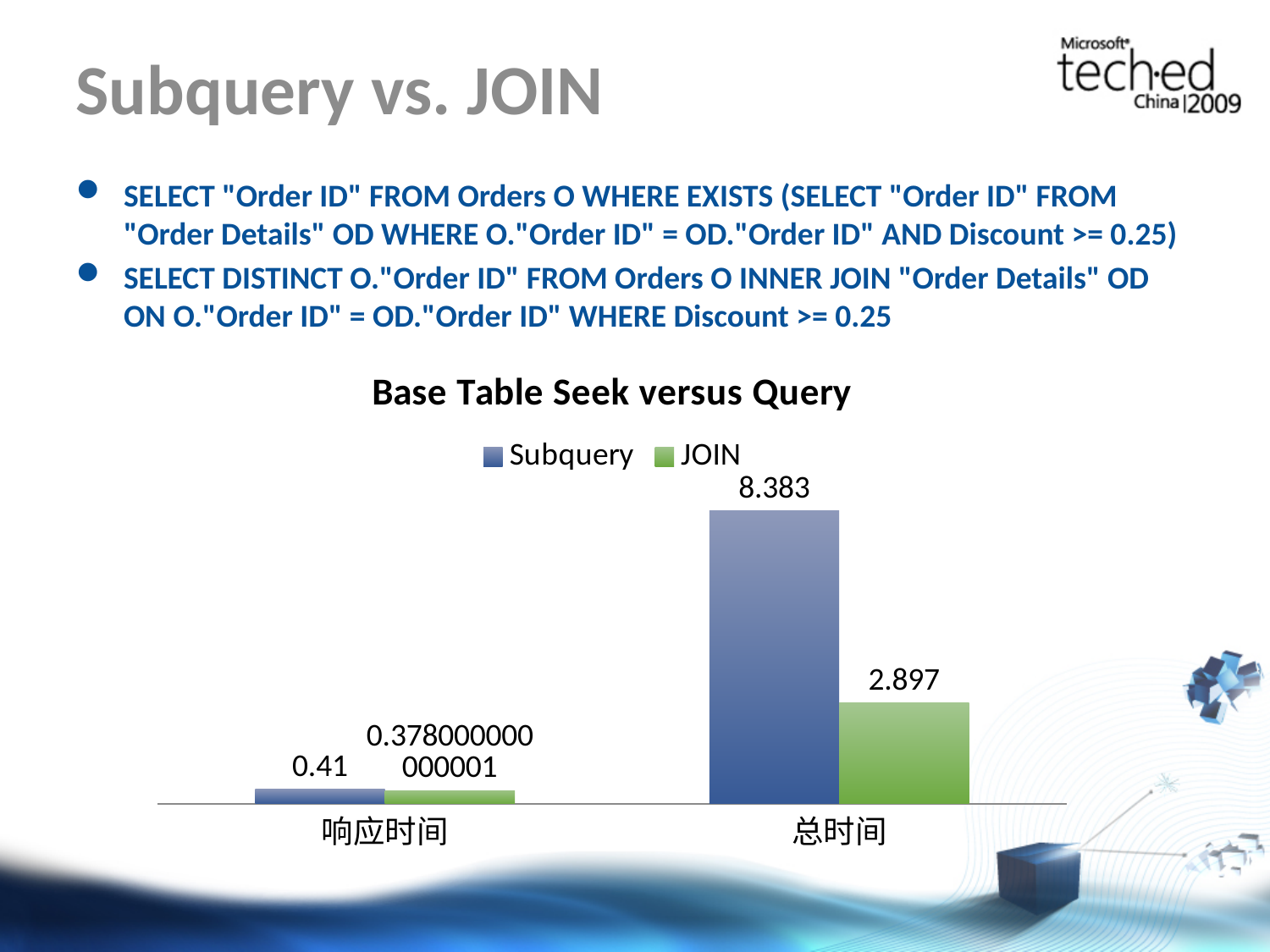
How many categories are shown on the x axis of the chart? 2 What is the title of the chart? Base Table Seek versus Query Which series has the higher value for 总时间, Subquery or JOIN? Subquery Which bar in the chart is the tallest? Subquery for 总时间 What is the Subquery value for 总时间? 8.383 What colour represents the JOIN series in the chart? green What is the JOIN value for 响应时间 as printed on the chart? 0.378000000000001 What is the difference between the Subquery and JOIN values for 总时间? 5.486 What is the JOIN value for 总时间? 2.897 What type of chart is shown on the slide? bar chart What is the Subquery value for 响应时间? 0.41 How many series does the chart legend list? 2